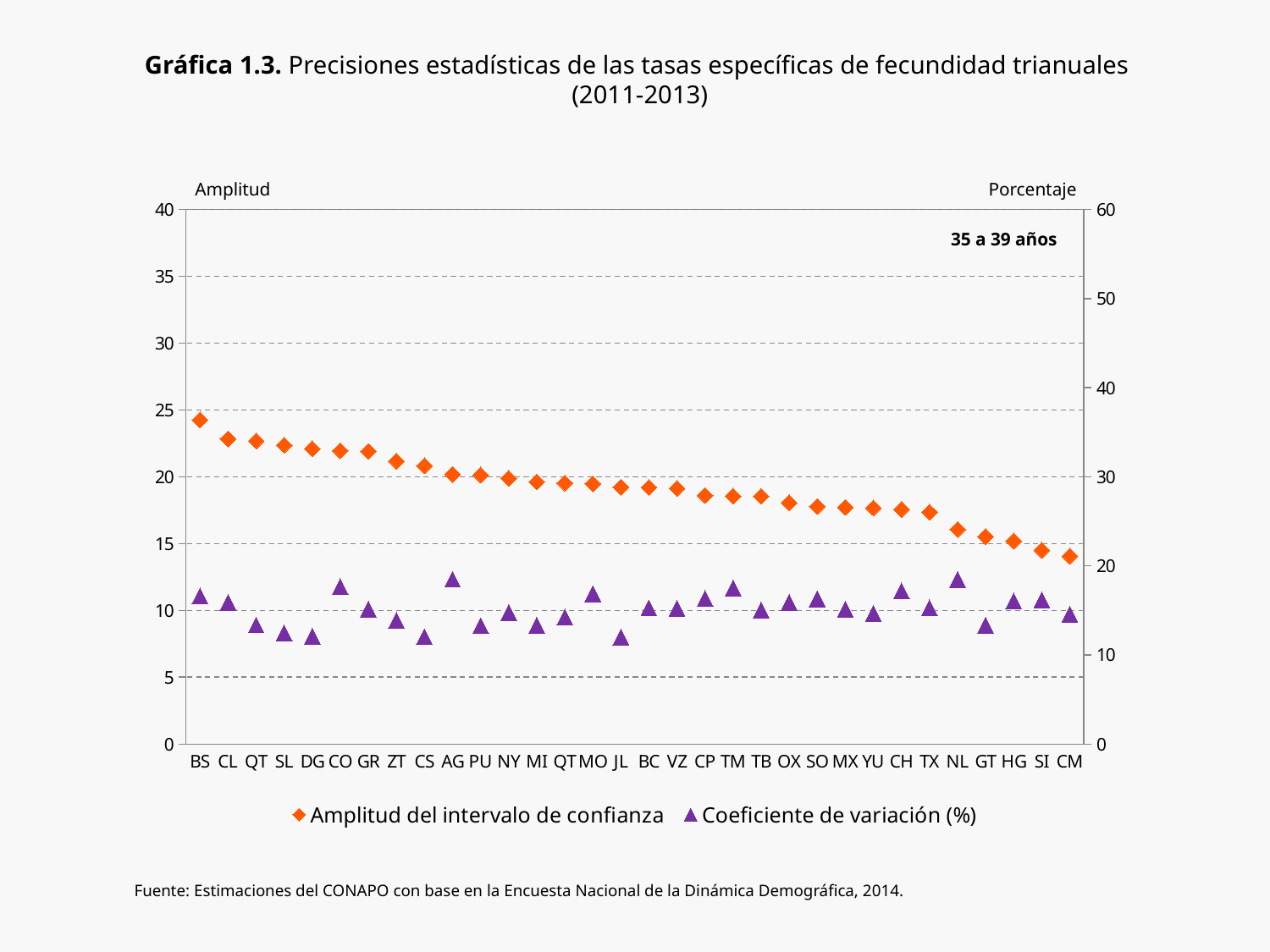
Which category has the lowest value for Amplitud del intervalo de confianza? CM What is the label of the right-hand vertical axis? Porcentaje Which category has the highest value for Amplitud del intervalo de confianza? BS Is the Amplitud del intervalo de confianza value for BS greater or less than 20? greater Do the values for Amplitud del intervalo de confianza rise or fall from left to right along the x axis? fall What kind of chart is shown on the slide? scatter chart How many categories are plotted along the x axis? 32 Which age group does the chart refer to, as labelled inside the plot area? 35 a 39 años How many series does the legend list? 2 Which has the larger Coeficiente de variación (%), AG or JL? AG Is the Amplitud del intervalo de confianza value for CM greater or less than 15? less Is the Amplitud del intervalo de confianza value for NL greater or less than 15? greater